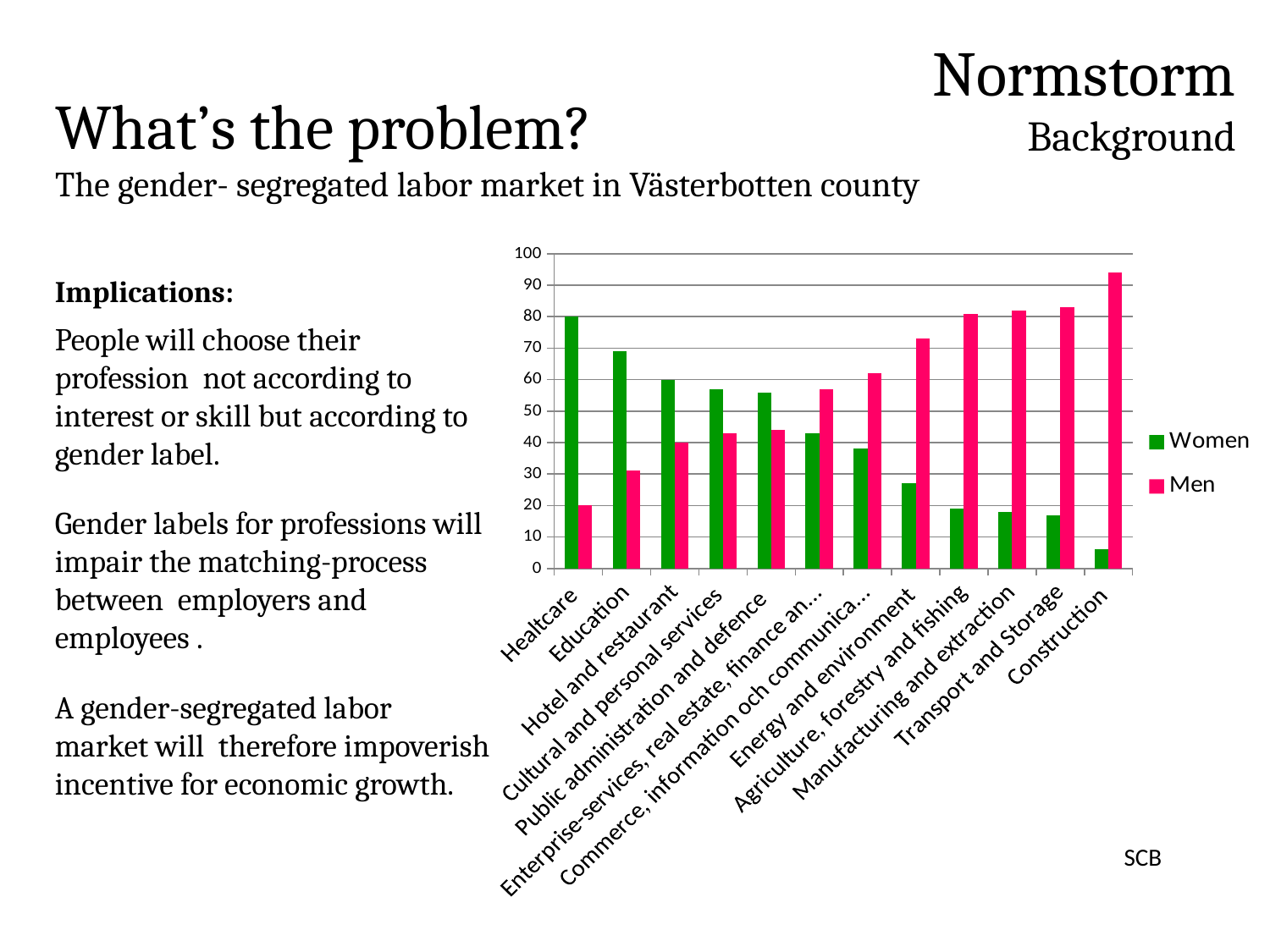
What kind of chart is shown on the slide? bar chart Do the values for Women generally rise or fall from left to right along the x axis? fall What colour represents the Men series in the chart? pink How many categories are shown on the x axis of the chart? 12 Which category has the lowest value for Women? Construction Which category has the highest value for Men? Construction How many series does the legend list? 2 Which category has the lowest value for Men? Healtcare In Education, which is larger, the value for Women or the value for Men? Women Is the value for Women in Energy and environment greater or less than 30? less Is the value for Men in Construction greater or less than 90? greater Which category has the highest value for Women? Healtcare